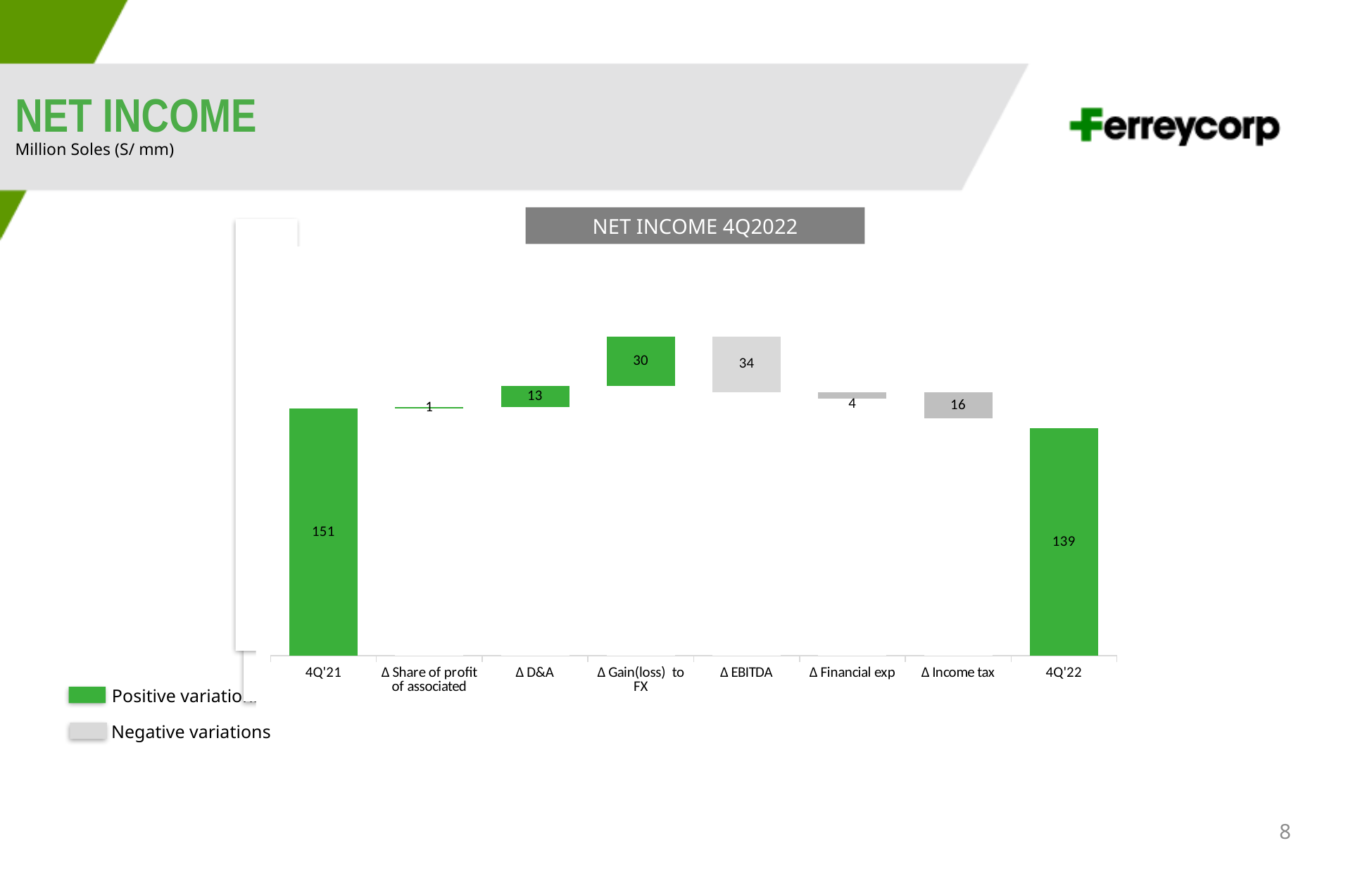
Which category has the lowest value in the chart? Δ Share of profit of associated How many categories are shown on the x axis of the chart? 8 Which is larger, the value for Δ EBITDA or the value for Δ Gain(loss) to FX? Δ EBITDA Which category has the highest value in the chart? 4Q'21 What value is shown for Δ EBITDA? 34 What is the net income value shown for 4Q'22? 139 What is the difference between the 4Q'21 and 4Q'22 net income values? 12 What value is shown for Δ Income tax? 16 How many entries does the legend list? 2 What value is shown for Δ D&A? 13 What is the net income value shown for 4Q'21? 151 What value is shown for Δ Gain(loss) to FX? 30